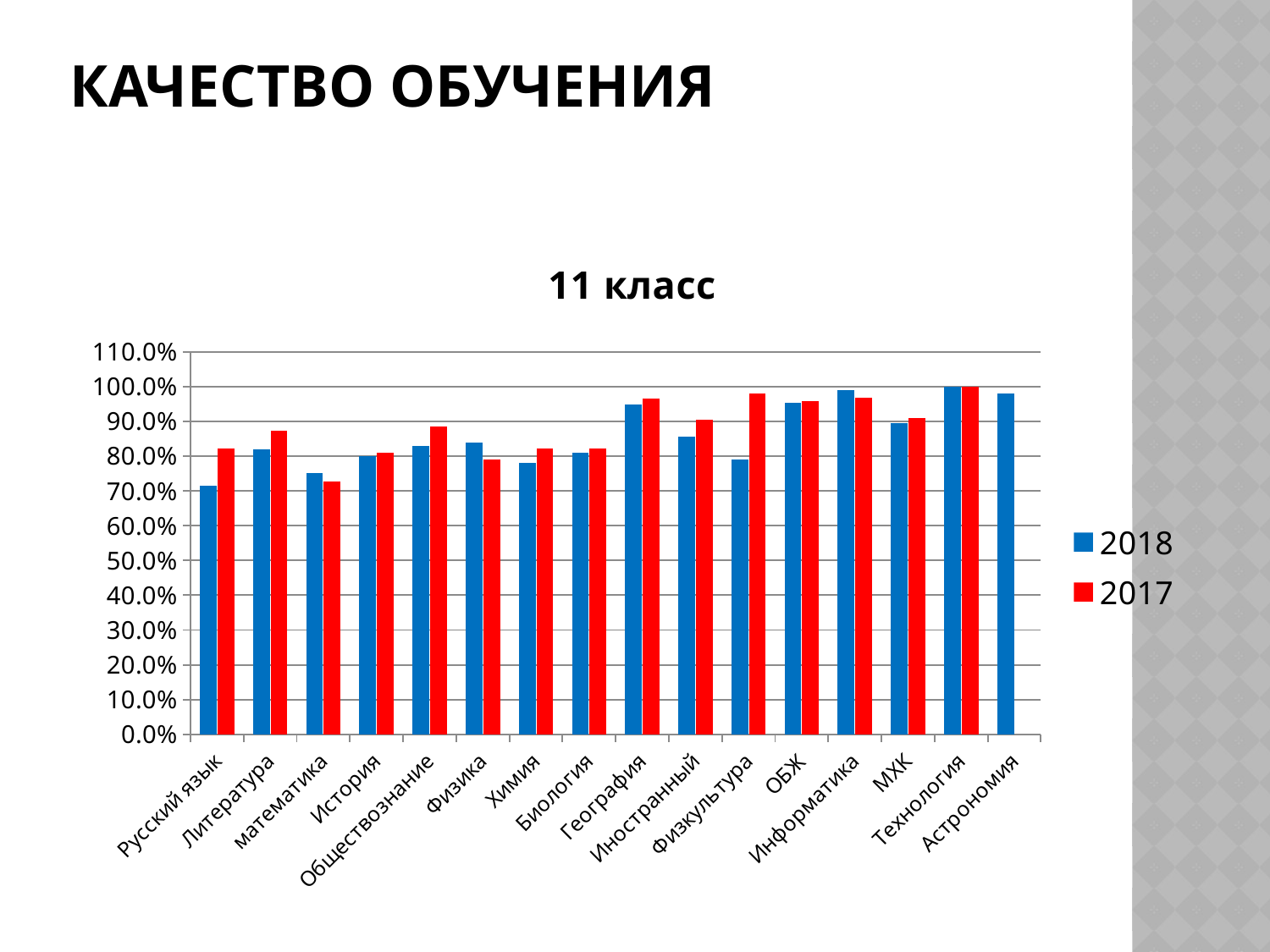
Is the 2018 value for Астрономия greater or less than 90.0%? greater Which subject has the lowest value for 2018? Русский язык For Физкультура, which year has the larger value, 2018 or 2017? 2017 Is the 2017 value for Физкультура greater or less than 90.0%? greater Which colour represents the 2018 series? blue Is the 2018 value for Русский язык greater or less than 80.0%? less How many subject categories are shown on the x axis? 16 How many series does the legend list? 2 Which subject has the lowest value for 2017? математика What kind of chart is shown on the slide? bar chart For Физика, which year has the larger value, 2018 or 2017? 2018 What is the title of the chart? 11 класс